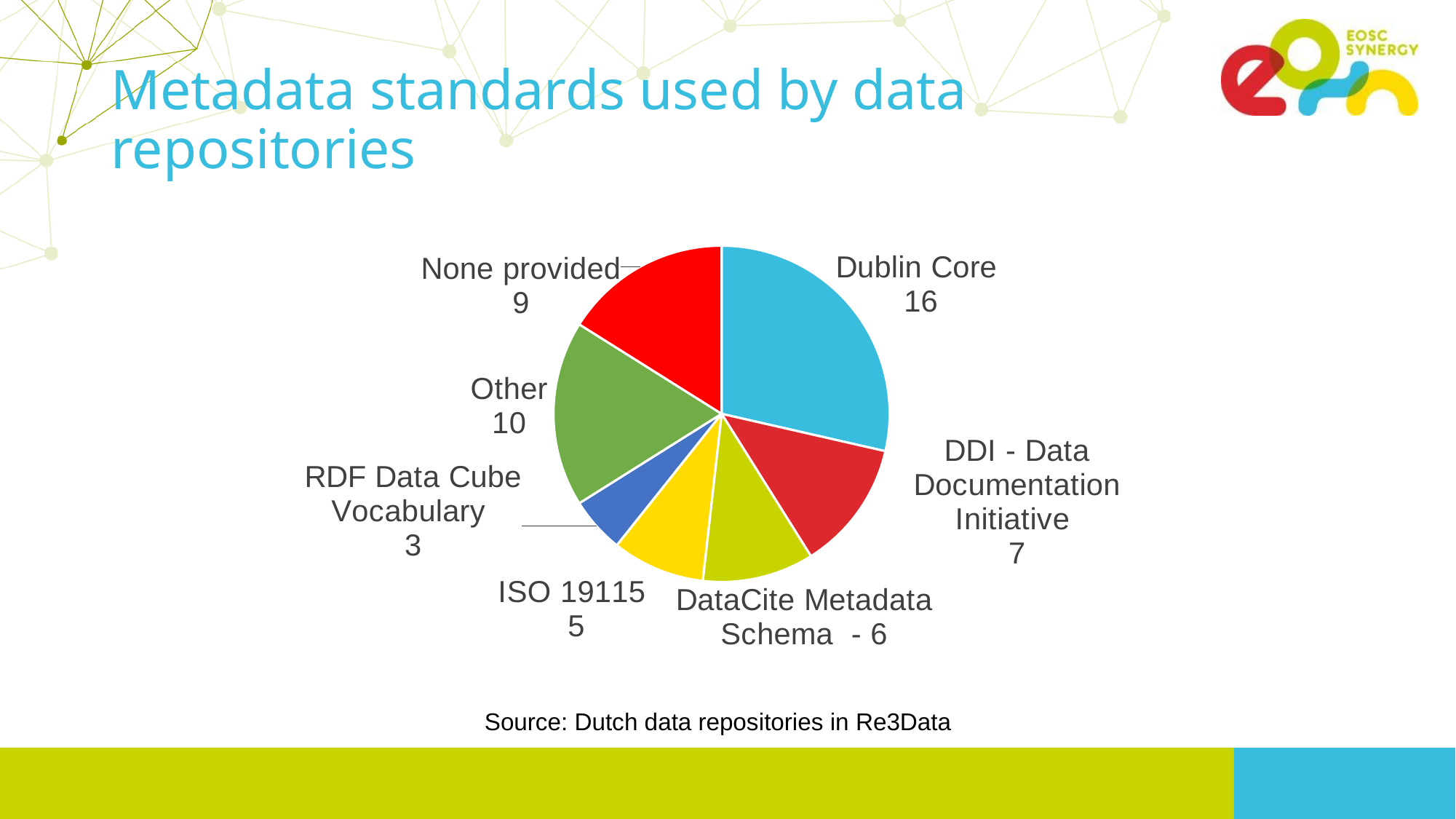
Which is larger, the value for ISO 19115 or the value for DataCite Metadata Schema? DataCite Metadata Schema What is the source given for the chart data? Dutch data repositories in Re3Data What value is shown for None provided? 9 What is the difference between the values for Dublin Core and Other? 6 Which category has the smallest slice in the pie chart? RDF Data Cube Vocabulary How many categories are shown in the pie chart? 7 What value is shown for RDF Data Cube Vocabulary? 3 What kind of chart is shown on the slide? Pie chart Which category has the largest slice in the pie chart? Dublin Core What value is shown for DDI - Data Documentation Initiative? 7 What value is shown for Dublin Core in the pie chart? 16 What share of the pie does DDI - Data Documentation Initiative represent? 12.5%